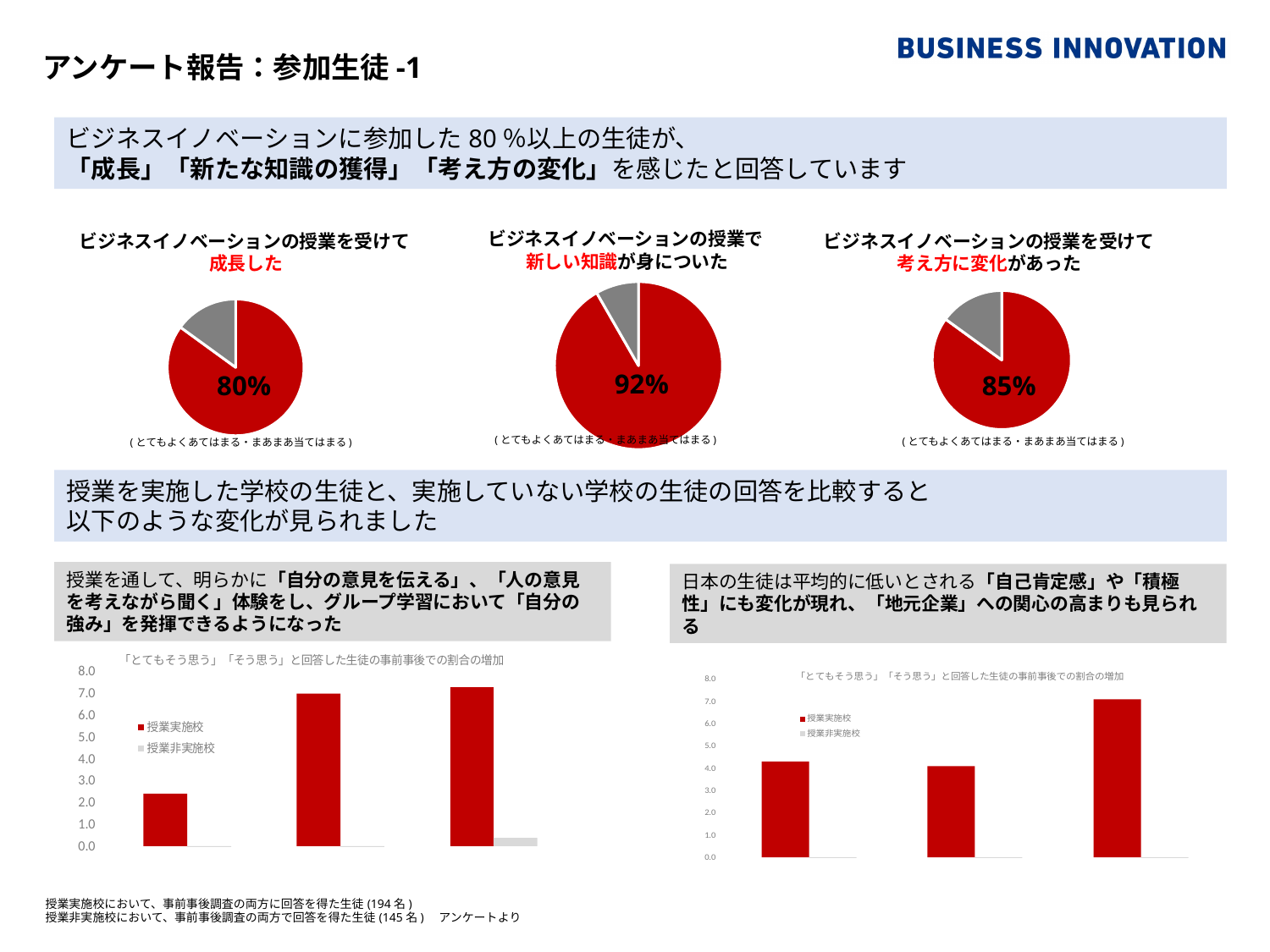
In the bottom-right bar chart, is the value of the third (rightmost) red bar greater or less than 6.0? greater In the pie chart titled 「ビジネスイノベーションの授業で新しい知識が身についた」, what percentage is shown? 92% In the bottom-left bar chart, is the value of the first (leftmost) red bar greater or less than 3.0? less How many pie charts are shown on the slide? 3 Among the three pie charts, which one shows the highest percentage? ビジネスイノベーションの授業で新しい知識が身についた (92%) What type of chart is used in the bottom-left chart of the slide? Bar chart In the bottom-left bar chart, is the value of the second red bar greater or less than 6.0? greater How many series does the legend of the bottom-left bar chart list? 2 What is the difference between the percentage in the 「新しい知識が身についた」 pie chart and the percentage in the 「成長した」 pie chart? 12% Among the three pie charts, which one shows the lowest percentage? ビジネスイノベーションの授業を受けて成長した (80%) In the pie chart titled 「ビジネスイノベーションの授業を受けて考え方に変化があった」, what percentage is shown? 85% In the pie chart titled 「ビジネスイノベーションの授業を受けて成長した」, what percentage is shown for the red slice? 80%